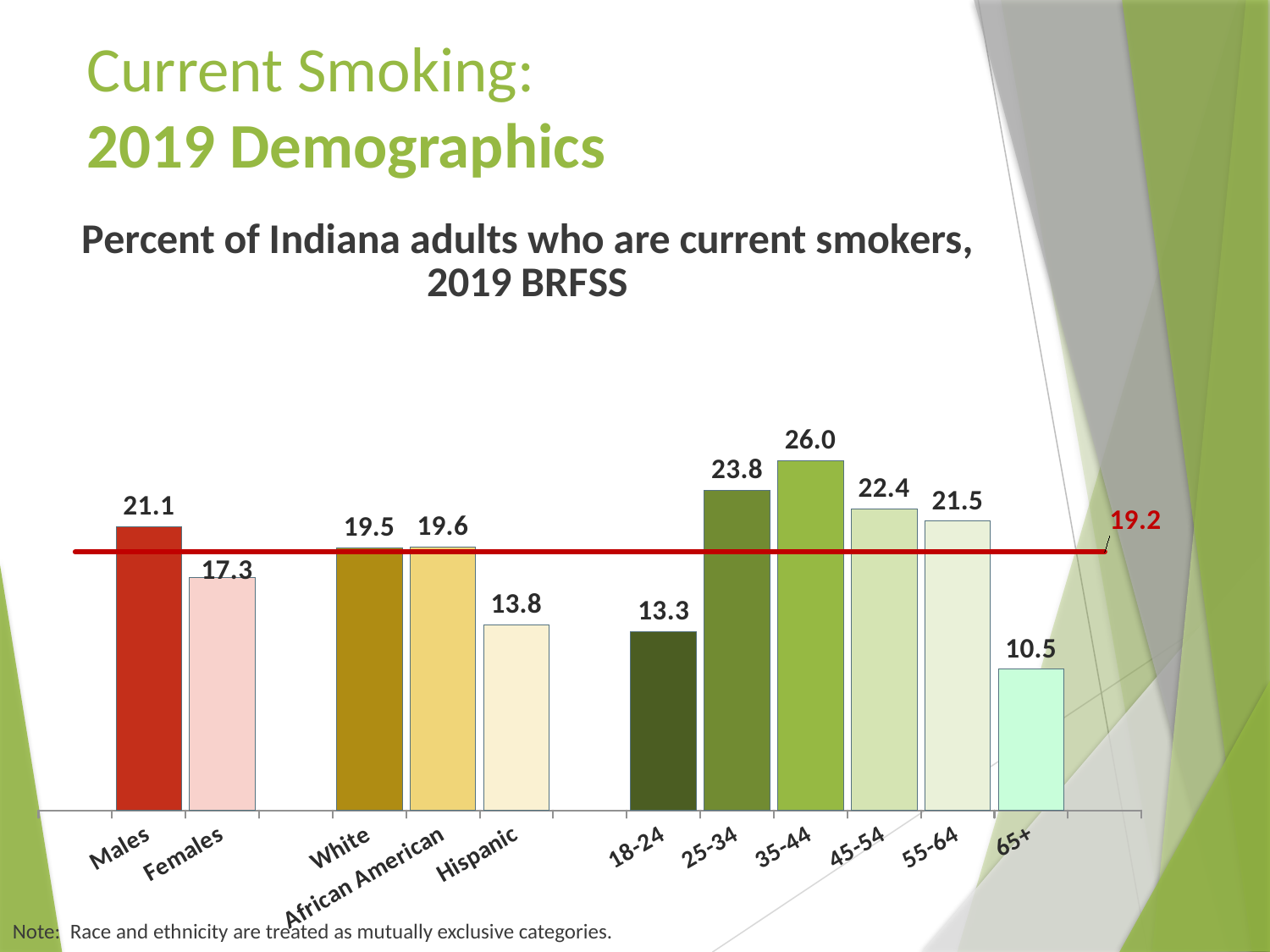
What value does the red horizontal reference line represent? 19.2 What is the percent of current smokers among Females? 17.3 What is the value shown for the Hispanic category? 13.8 What is the percent of current smokers among Males? 21.1 What is the value shown for the 65+ age group? 10.5 How many categories are plotted in the chart? 11 Which category has the lowest percent of current smokers? 65+ Which category has the highest percent of current smokers? 35-44 What is the difference between the values for Males and Females? 3.8 What is the difference between the values for the 35-44 and 18-24 age groups? 12.7 What kind of chart is shown on the slide? Bar chart Which has a higher value, the 25-34 age group or the 45-54 age group? 25-34